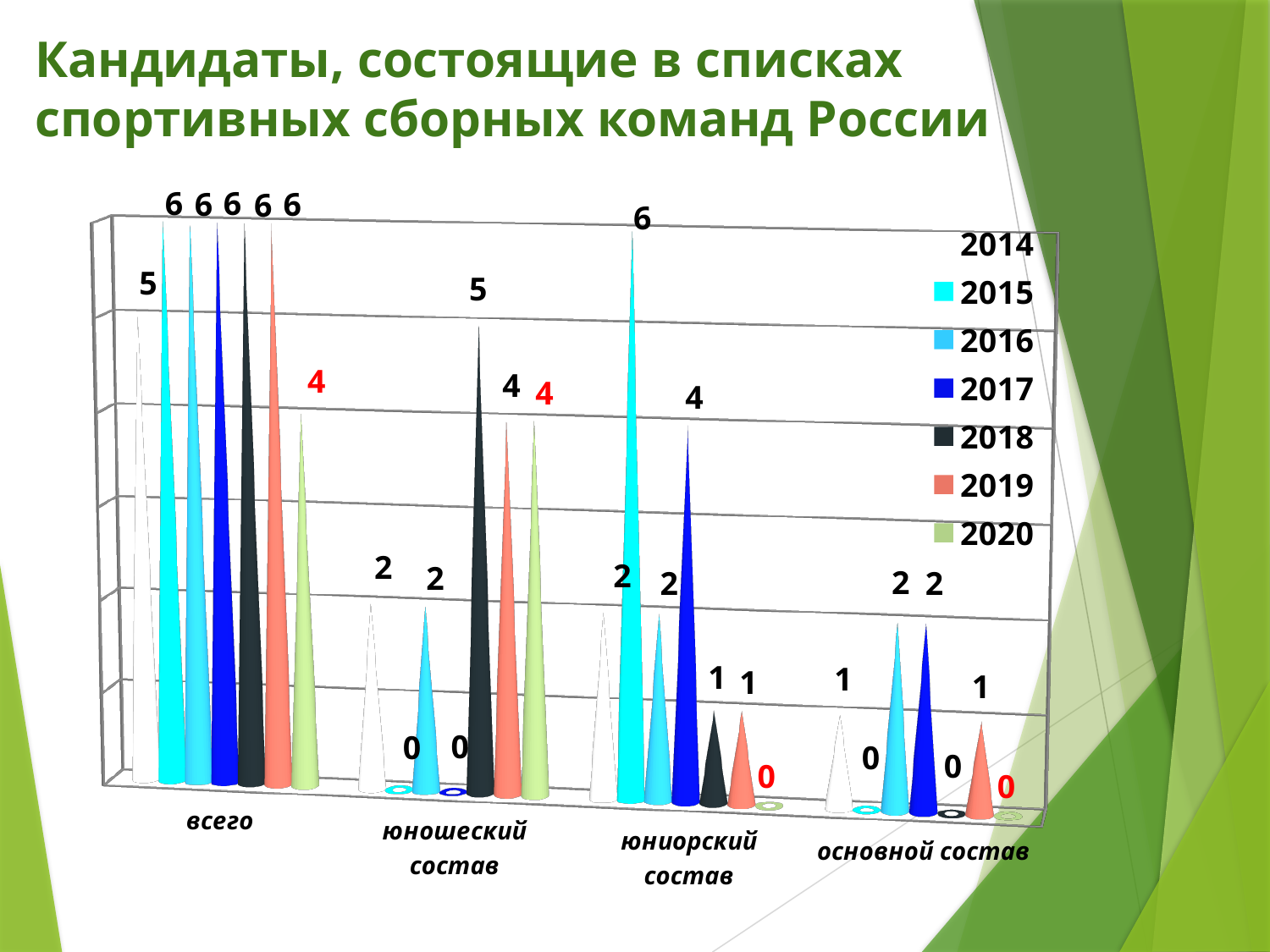
How many series does the legend list? 7 What is the value for 2015 in the юниорский состав category? 6 What is the value for 2018 in the юношеский состав category? 5 How many categories are shown on the x axis? 4 What is the difference between the 2018 and 2019 values in the юношеский состав category? 1 Which is larger in the юниорский состав category: the value for 2017 or the value for 2016? 2017 What is the title of the chart on the slide? Кандидаты, состоящие в списках спортивных сборных команд России What kind of chart is shown on the slide? bar chart What is the value for 2020 in the всего category? 4 Which year has the highest value in the юниорский состав category? 2015 Which year has the lowest value in the всего category? 2020 What is the value for 2016 in the основной состав category? 2